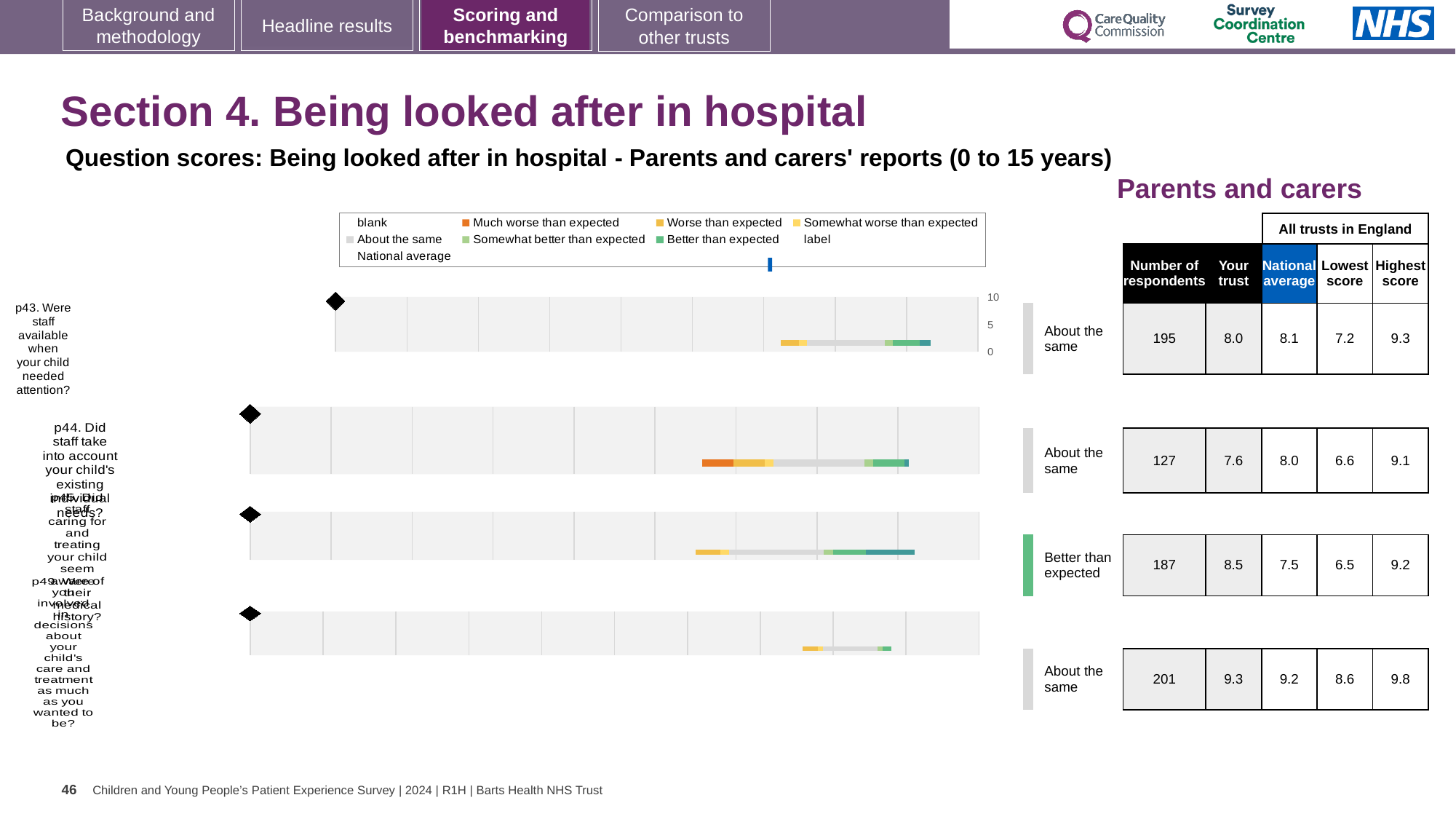
In the table beside the chart, what is the 'Your trust' score for p44 (Did staff take into account your child's existing individual needs?)? 7.6 Across the four rows of the table, what is the largest number of respondents? 201 What kind of chart is used to show the question scores? Bar chart For the third row (p45, rated 'Better than expected'), what is the difference between the 'Your trust' score and the national average? 1.0 For p43, which is larger: the 'Your trust' score or the national average? National average Which question row is rated 'Better than expected' rather than 'About the same'? p45 (the third row) In the table beside the chart, what is the national average for p44? 8.0 In the table beside the chart, what is the highest score shown for the bottom row (p49)? 9.8 Across the four rows of the table, what is the lowest 'Your trust' score? 7.6 In the table beside the chart, how many respondents are shown for p43 (Were staff available when your child needed attention?)? 195 In the table beside the chart, what is the lowest score shown for p44? 6.6 How many survey questions are plotted in the chart? 4